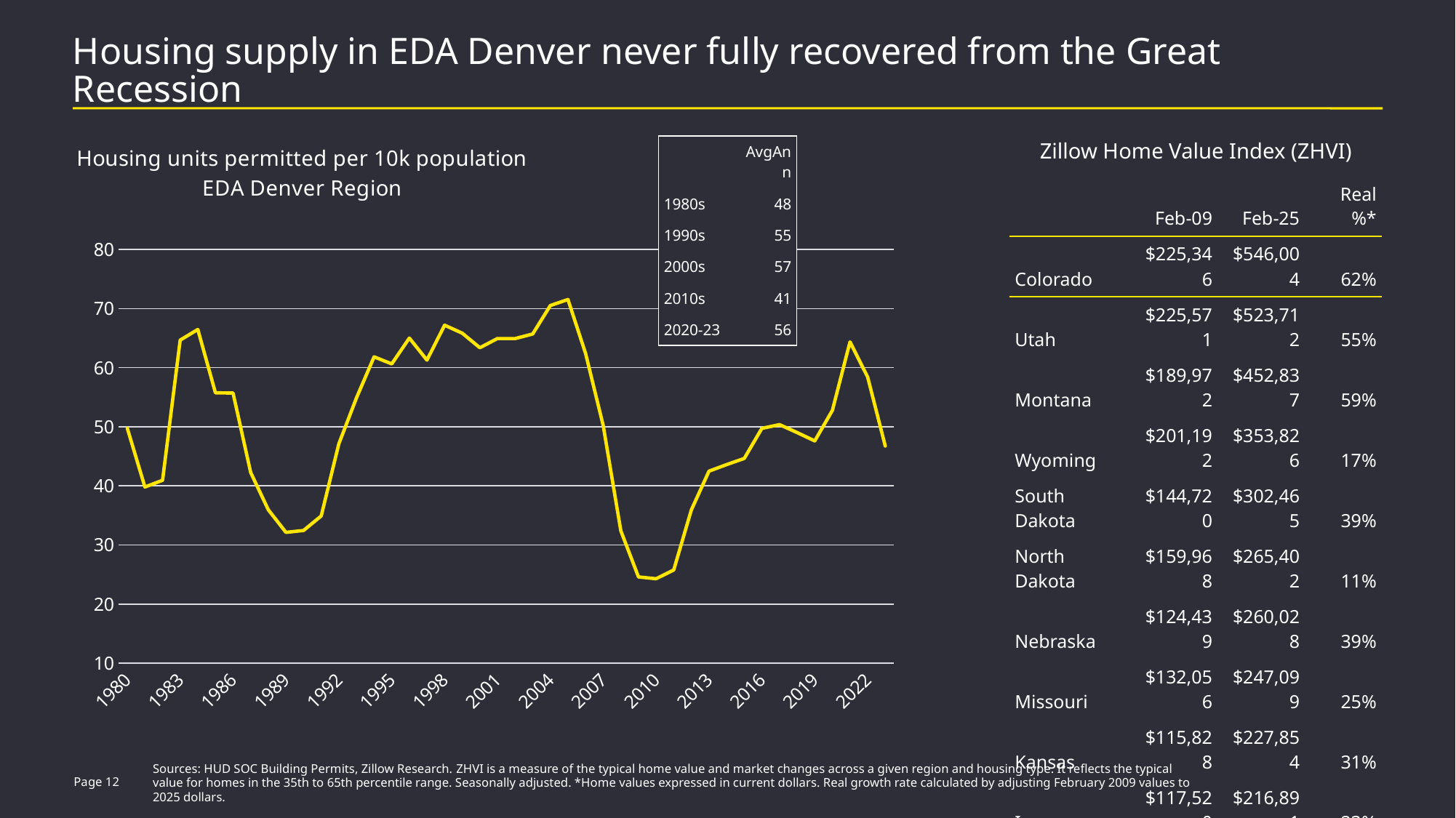
According to the AvgAnn table inset on the chart, what is the average annual value for the 2010s? 41 How many year labels are shown along the x axis of the chart? 15 Is the value for 1998 greater or less than 60? greater Is the value for 1989 greater or less than 40? less Do the values rise or fall between 2007 and 2010? fall Is the value for 2022 greater or less than 60? less Do the values rise or fall between 1989 and 1995? rise What kind of chart is shown on the slide? line chart What colour is the line plotted in the chart? yellow What is the title of the chart on the left of the slide? Housing units permitted per 10k population EDA Denver Region